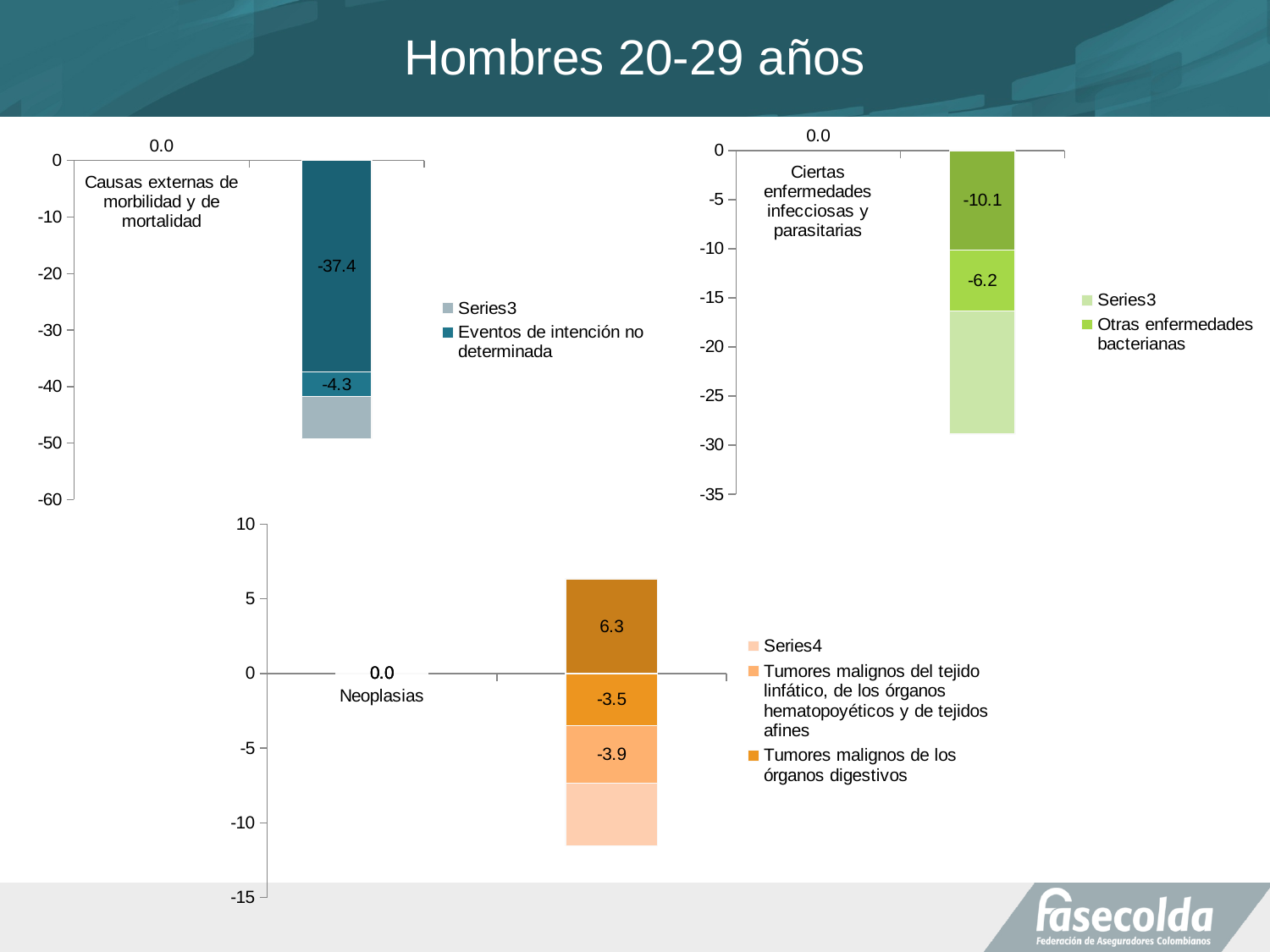
In the top-right chart (Ciertas enfermedades infecciosas y parasitarias), what value is printed on the segment for Otras enfermedades bacterianas? -6.2 In the top-left chart (Causas externas de morbilidad y de mortalidad), what value is printed on the smaller labelled segment of the bar? -4.3 In the bottom chart (Neoplasias), what value is printed on the segment for Tumores malignos del tejido linfático, de los órganos hematopoyéticos y de tejidos afines? -3.9 What kind of chart is the bottom chart (Neoplasias)? Bar chart How many series does the legend of the bottom chart (Neoplasias) list? 3 In the top-right chart (Ciertas enfermedades infecciosas y parasitarias), what is the difference between the two labelled segment values, -10.1 and -6.2? 3.9 What is the title of the slide? Hombres 20-29 años How many series does the legend of the top-right chart (Ciertas enfermedades infecciosas y parasitarias) list? 2 In the top-left chart (Causas externas de morbilidad y de mortalidad), what value is printed on the largest labelled segment of the bar? -37.4 How many series does the legend of the top-left chart (Causas externas de morbilidad y de mortalidad) list? 2 In the top-right chart (Ciertas enfermedades infecciosas y parasitarias), what value is printed on the topmost segment of the bar? -10.1 In the bottom chart (Neoplasias), what value is printed on the segment for Tumores malignos de los órganos digestivos? -3.5